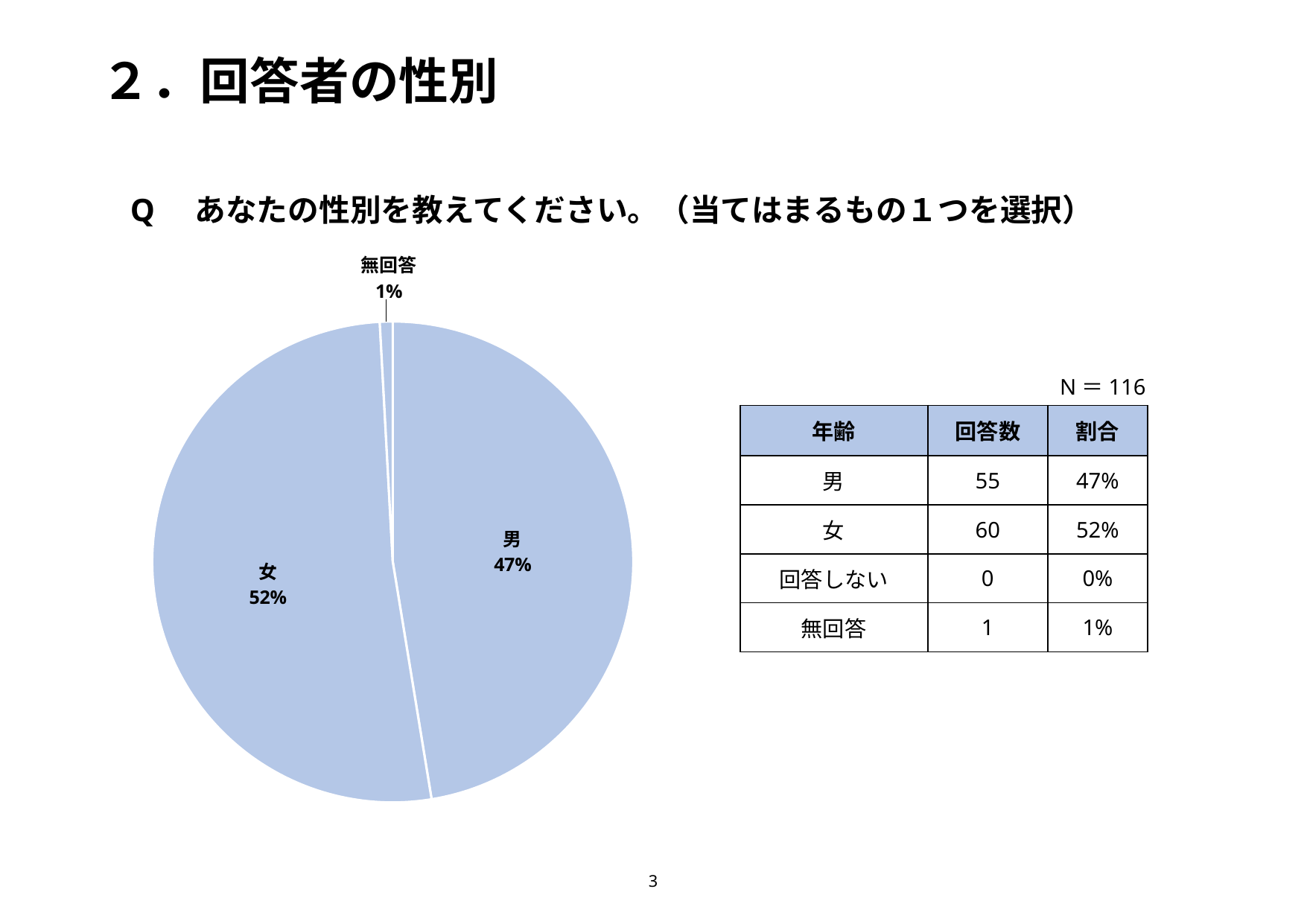
What share of the pie does 女 represent? 52% What share of the pie does 男 represent? 47% How many labeled slices does the pie chart have? 3 What is the difference in percentage points between the 女 slice and the 男 slice? 5% Which is larger in the pie chart, 男 or 女? 女 What colour are the slices of the pie chart? light blue What is the difference in percentage points between the 男 slice and the 無回答 slice? 46% Which slice of the pie chart is the largest? 女 What kind of chart is shown on the slide? pie chart What share of the pie does 無回答 represent? 1% Which slice of the pie chart is the smallest? 無回答 What is the N value shown next to the table on the slide? N = 116